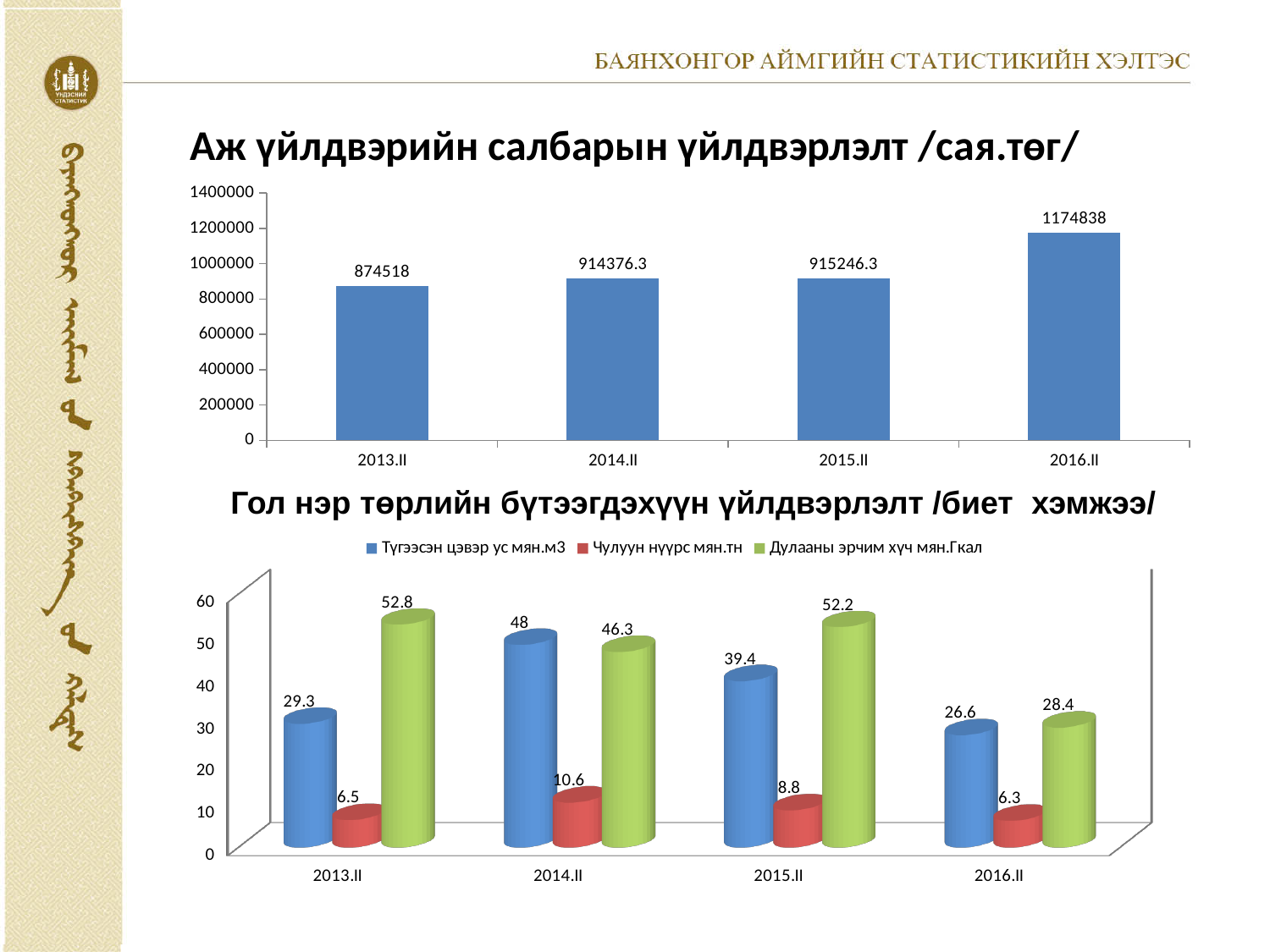
In the top chart 'Аж үйлдвэрийн салбарын үйлдвэрлэлт /сая.төг/', what is the value for 2013.II? 874518 In the bottom chart 'Гол нэр төрлийн бүтээгдэхүүн үйлдвэрлэлт /биет хэмжээ/', what is the value of 'Чулуун нүүрс мян.тн' for 2014.II? 10.6 In the top chart 'Аж үйлдвэрийн салбарын үйлдвэрлэлт /сая.төг/', do the values rise or fall from 2013.II to 2016.II? rise In the bottom chart 'Гол нэр төрлийн бүтээгдэхүүн үйлдвэрлэлт /биет хэмжээ/', how many series does the legend list? 3 In the bottom chart 'Гол нэр төрлийн бүтээгдэхүүн үйлдвэрлэлт /биет хэмжээ/', what is the value of 'Дулааны эрчим хүч мян.Гкал' for 2013.II? 52.8 In the bottom chart 'Гол нэр төрлийн бүтээгдэхүүн үйлдвэрлэлт /биет хэмжээ/', which is larger for 2016.II: 'Түгээсэн цэвэр ус мян.м3' or 'Дулааны эрчим хүч мян.Гкал'? Дулааны эрчим хүч мян.Гкал What kind of chart is the top chart 'Аж үйлдвэрийн салбарын үйлдвэрлэлт /сая.төг/'? bar chart In the bottom chart 'Гол нэр төрлийн бүтээгдэхүүн үйлдвэрлэлт /биет хэмжээ/', which period has the highest value for 'Түгээсэн цэвэр ус мян.м3'? 2014.II In the top chart 'Аж үйлдвэрийн салбарын үйлдвэрлэлт /сая.төг/', what is the value for 2016.II? 1174838 In the top chart 'Аж үйлдвэрийн салбарын үйлдвэрлэлт /сая.төг/', how many periods are shown on the x axis? 4 In the top chart 'Аж үйлдвэрийн салбарын үйлдвэрлэлт /сая.төг/', what is the difference between the 2016.II and 2015.II values? 259591.7 In the top chart 'Аж үйлдвэрийн салбарын үйлдвэрлэлт /сая.төг/', which period has the lowest value? 2013.II